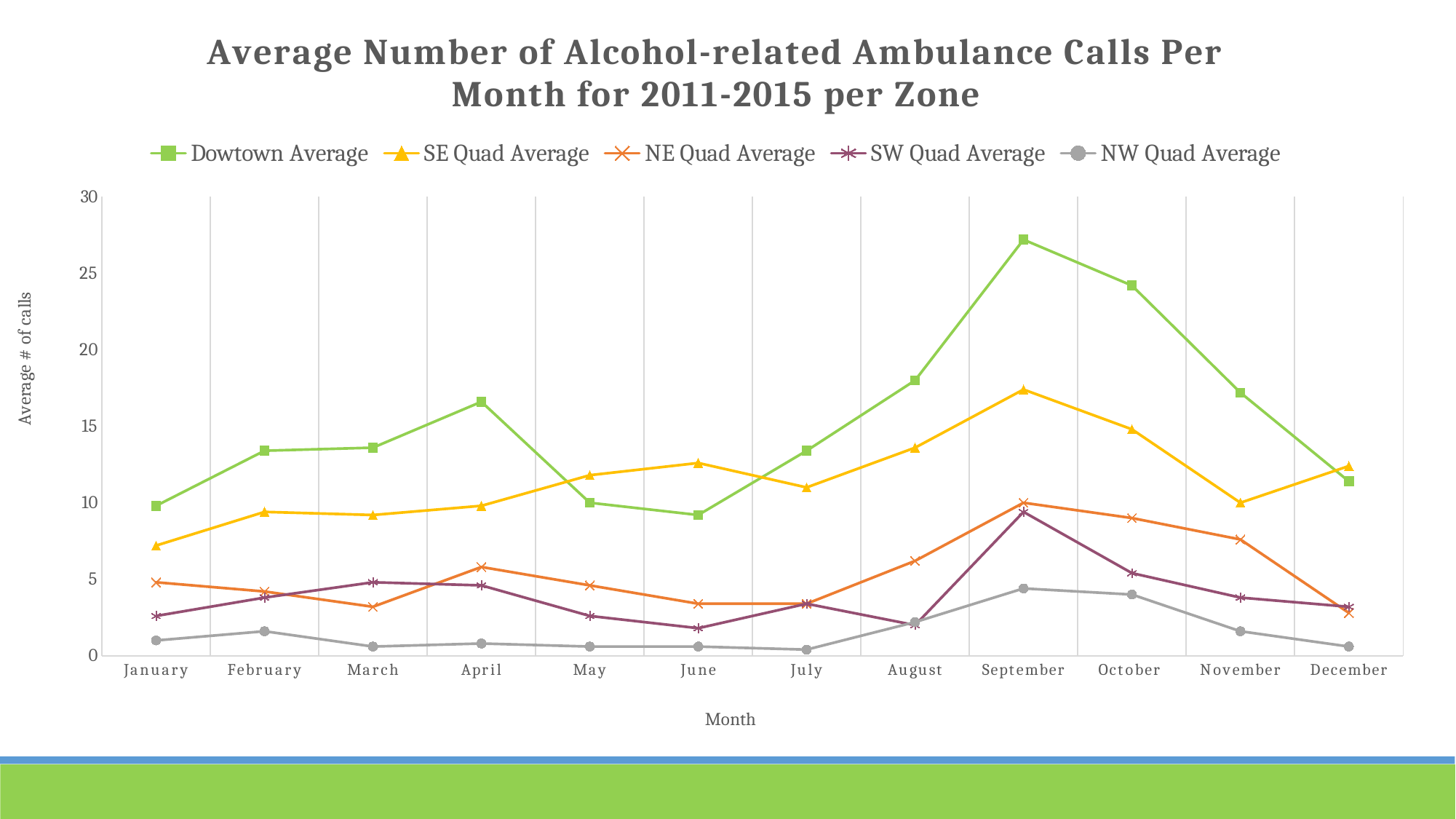
What is the label on the y axis? Average # of calls How many months are plotted along the x axis? 12 Which series has the highest value in September? Dowtown Average Does the Dowtown Average rise or fall from September to December? fall In which month is the Dowtown Average at its highest? September How many series does the legend list? 5 What kind of chart is shown on the slide? line chart In May, which is higher, the Dowtown Average or the SE Quad Average? SE Quad Average Is the NW Quad Average for September greater or less than 5? less Is the Dowtown Average for September greater or less than 25? greater Is the SE Quad Average for September greater or less than 15? greater In which month is the SE Quad Average at its lowest? January